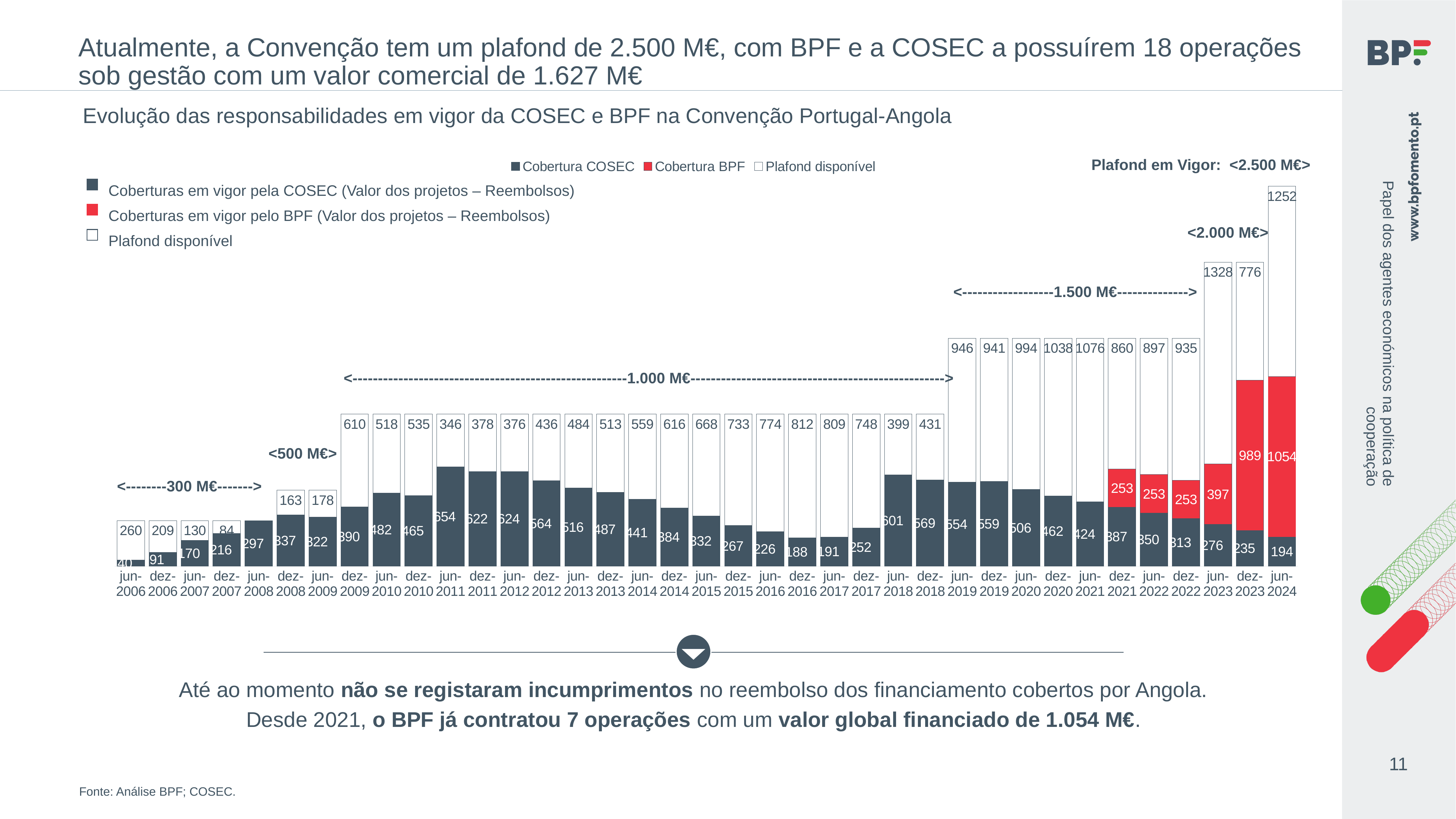
What is the Plafond disponível value for jun-2021? 1076 Does the Cobertura COSEC value rise or fall from dez-2021 to jun-2024? fall What is the total of the stacked bar for jun-2024? 2500 How many series does the chart legend list? 3 What kind of chart is shown on the slide? bar chart What is the Cobertura BPF value for dez-2023? 989 Which has the larger Cobertura COSEC value, jun-2011 or jun-2018? jun-2011 In which period is the Cobertura COSEC value lowest? jun-2006 How many periods are shown on the x axis? 37 What is the difference between the Cobertura BPF values for jun-2024 and dez-2023? 65 In which period is the Cobertura BPF value highest? jun-2024 What is the Cobertura COSEC value for jun-2024? 194